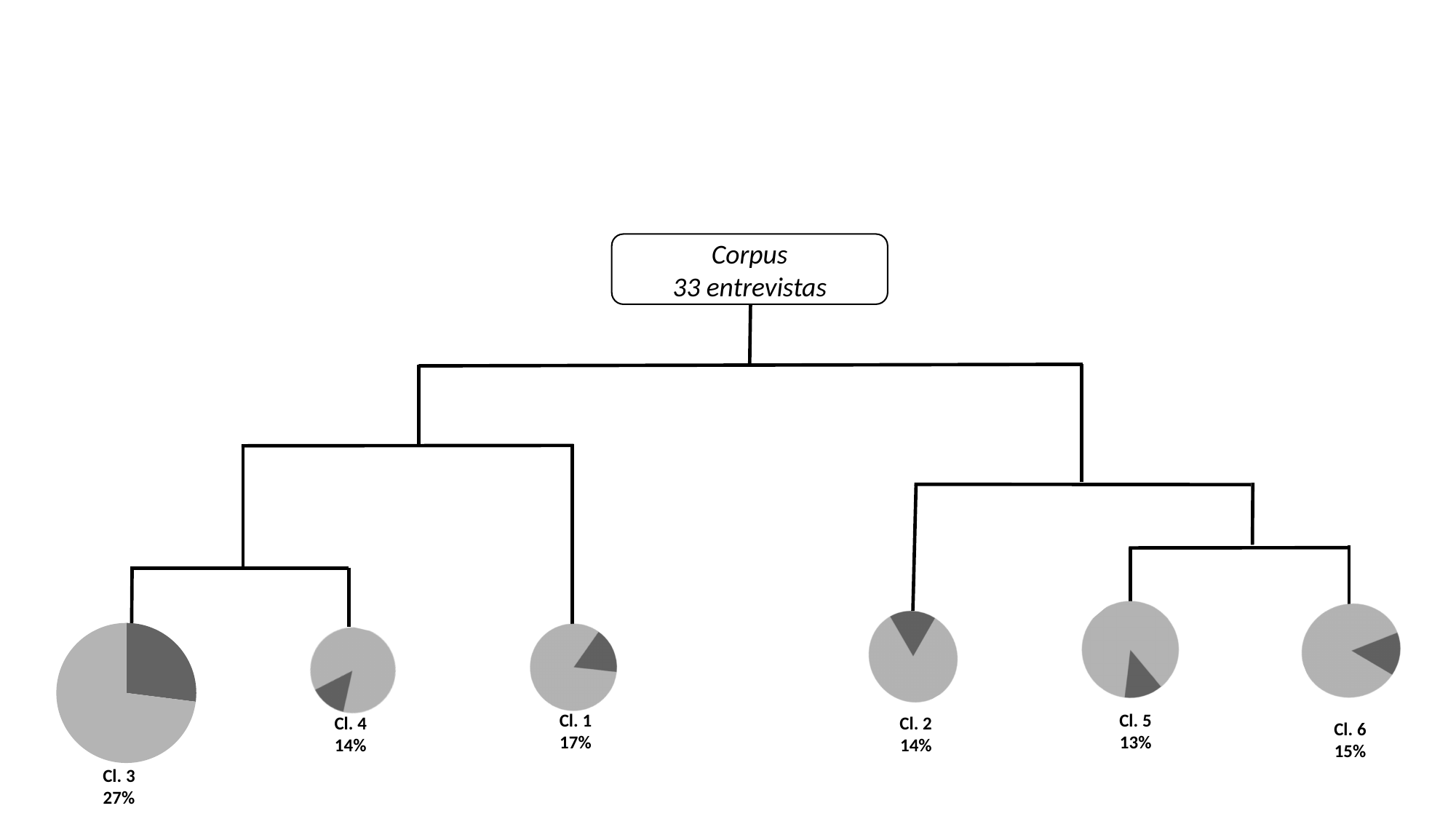
Which has a larger percentage, Cl. 6 or Cl. 2? Cl. 6 What percentage is shown for Cl. 3? 27% What percentage is shown for Cl. 6? 15% Which cluster has the lowest percentage? Cl. 5 How many interviews does the corpus at the top of the tree contain? 33 entrevistas What is the difference in percentage points between Cl. 3 and Cl. 1? 10 What kind of chart is used to represent each cluster? Pie chart What is the sum of the percentages of Cl. 4 and Cl. 2? 28% Which cluster has the highest percentage? Cl. 3 What percentage is shown for Cl. 5? 13% How many pie charts are shown on the slide? 6 What percentage is shown for Cl. 1? 17%